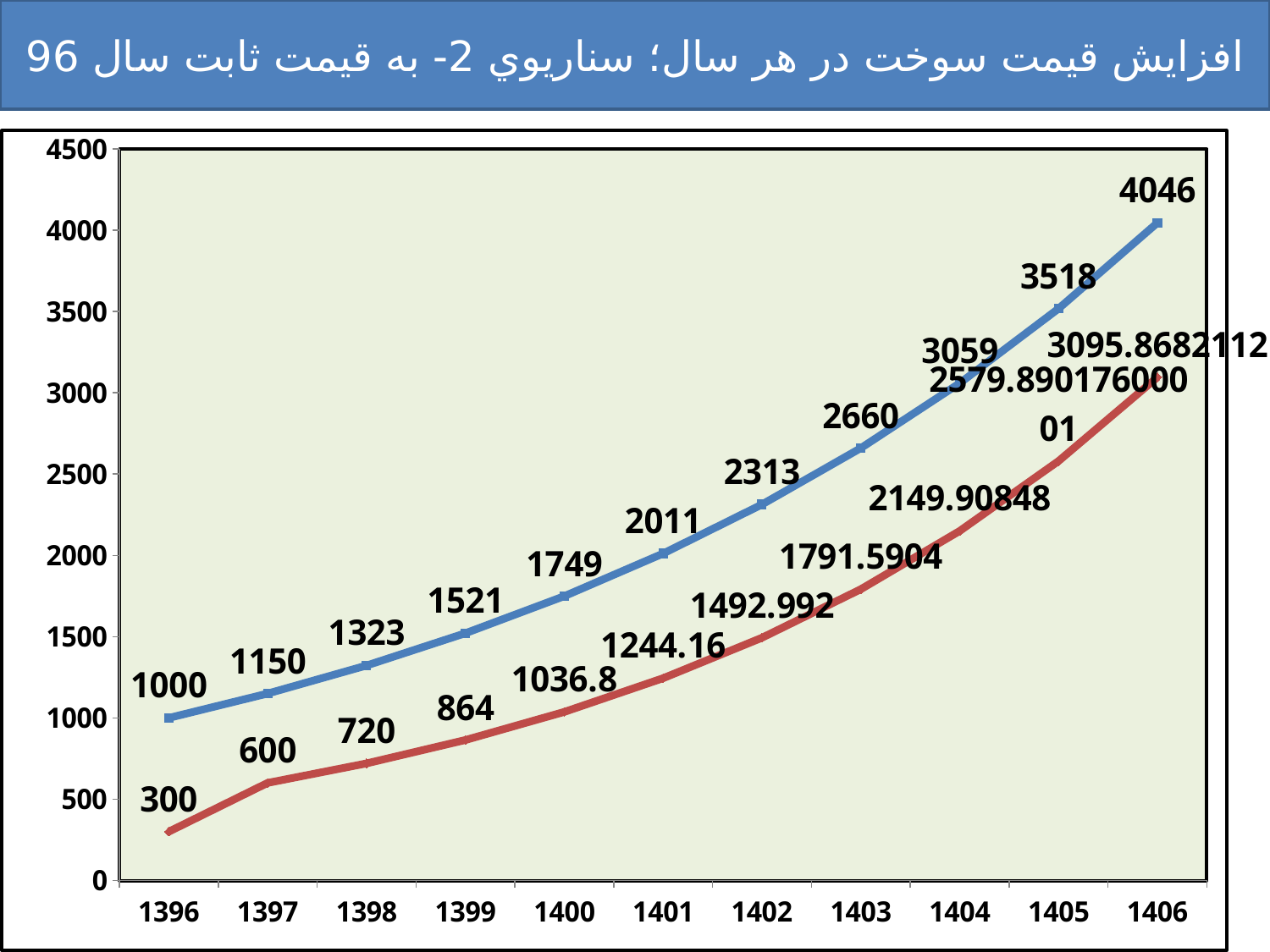
In which year does the blue line reach its highest value? 1406 What is the value of the blue line in 1402? 2313 What is the value of the red line in 1396? 300 Do the values of the blue line rise or fall from 1396 to 1406? rise What type of chart is shown on the slide? line chart What is the value of the red line in 1400? 1036.8 In which year is the red line at its lowest value? 1396 How many years are shown on the x axis of the chart? 11 What is the difference between the blue line values in 1406 and 1405? 528 What is the value of the blue line in 1406? 4046 What is the value of the blue line in 1396? 1000 What is the value of the red line in 1403? 1791.5904